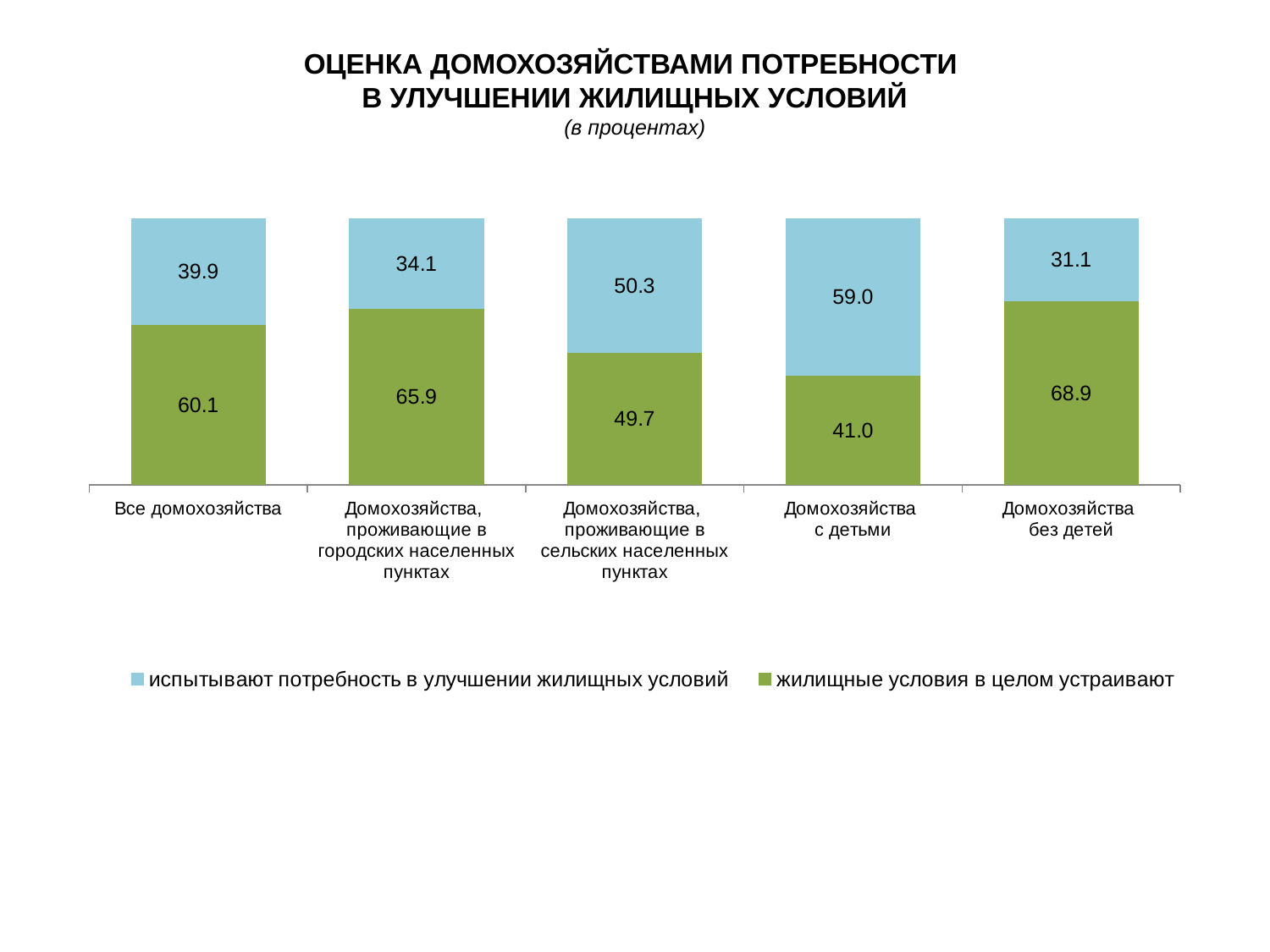
Which colour represents "жилищные условия в целом устраивают" in the legend? Green What is the value of "испытывают потребность в улучшении жилищных условий" for "Все домохозяйства"? 39.9 Which category has the lowest value for "жилищные условия в целом устраивают"? Домохозяйства с детьми What type of chart is shown on the slide? Stacked bar chart How many series does the legend list? 2 Which category has the highest value for "испытывают потребность в улучшении жилищных условий"? Домохозяйства с детьми What is the value of "жилищные условия в целом устраивают" for "Домохозяйства с детьми"? 41.0 What is the total of the stacked bar for "Домохозяйства без детей"? 100.0 What is the value of "жилищные условия в целом устраивают" for "Домохозяйства, проживающие в сельских населенных пунктах"? 49.7 Which is larger: the "испытывают потребность в улучшении жилищных условий" value for "Домохозяйства, проживающие в городских населенных пунктах" or for "Домохозяйства, проживающие в сельских населенных пунктах"? Домохозяйства, проживающие в сельских населенных пунктах What is the difference between the "жилищные условия в целом устраивают" values for "Домохозяйства без детей" and "Домохозяйства с детьми"? 27.9 How many categories are shown on the x axis? 5